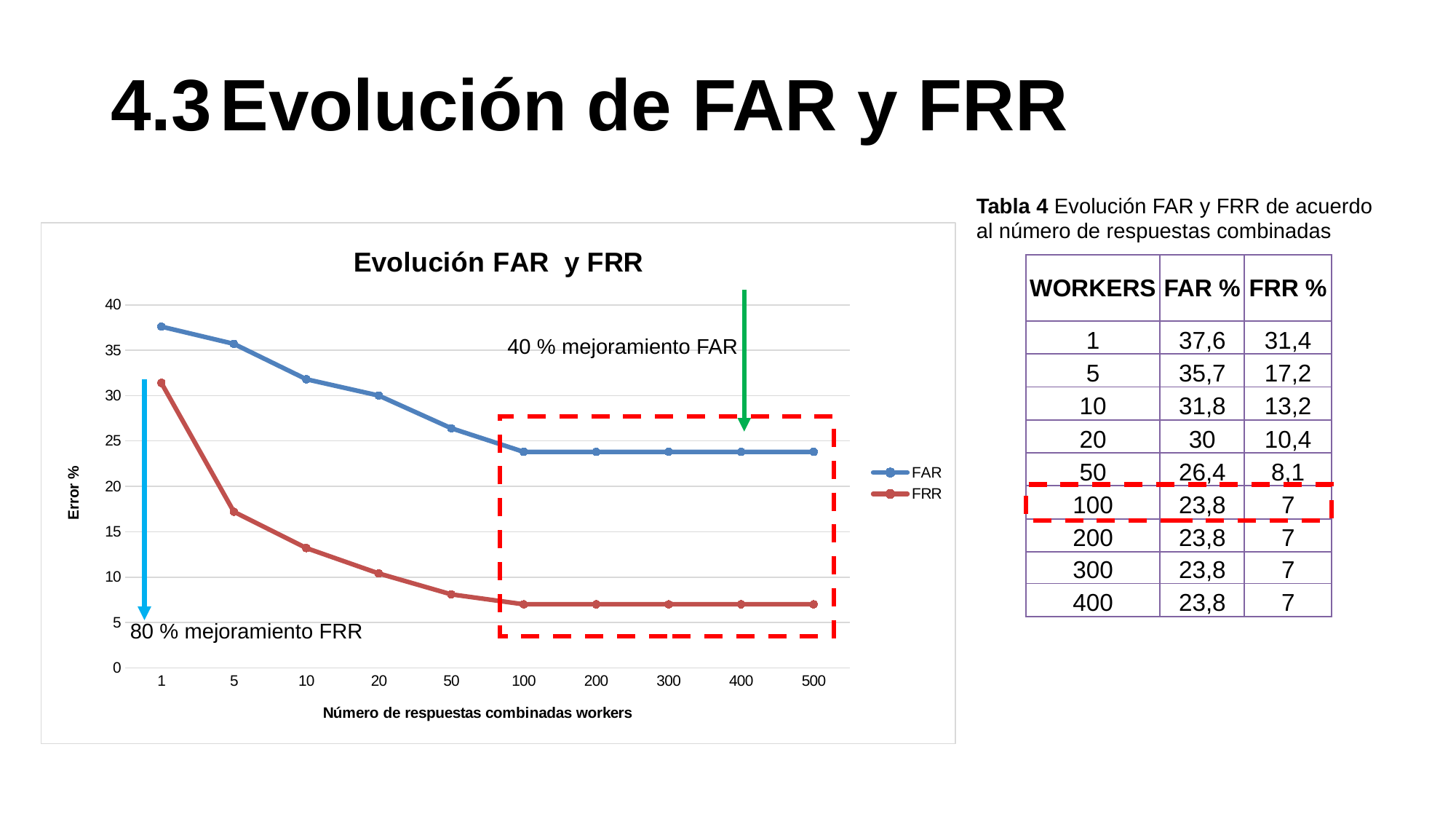
What is the label of the y axis? Error % How many points are plotted along the x axis for each series? 10 According to the table on the slide, what is the difference between FAR % and FRR % at 1 worker? 6,2 According to the table on the slide, what is the FAR % for 50 workers? 26,4 Which series has the higher value at 1 worker, FAR or FRR? FAR How many series does the chart legend list? 2 Is the FRR value at 100 workers greater or less than 10? less Is the FAR value at 10 workers greater or less than 30? greater What kind of chart is shown on the slide? line chart Does the FAR series rise or fall as the number of combined worker responses increases from 1 to 100? fall Is the FRR value at 5 workers greater or less than 20? less What is the title of the chart? Evolución FAR y FRR